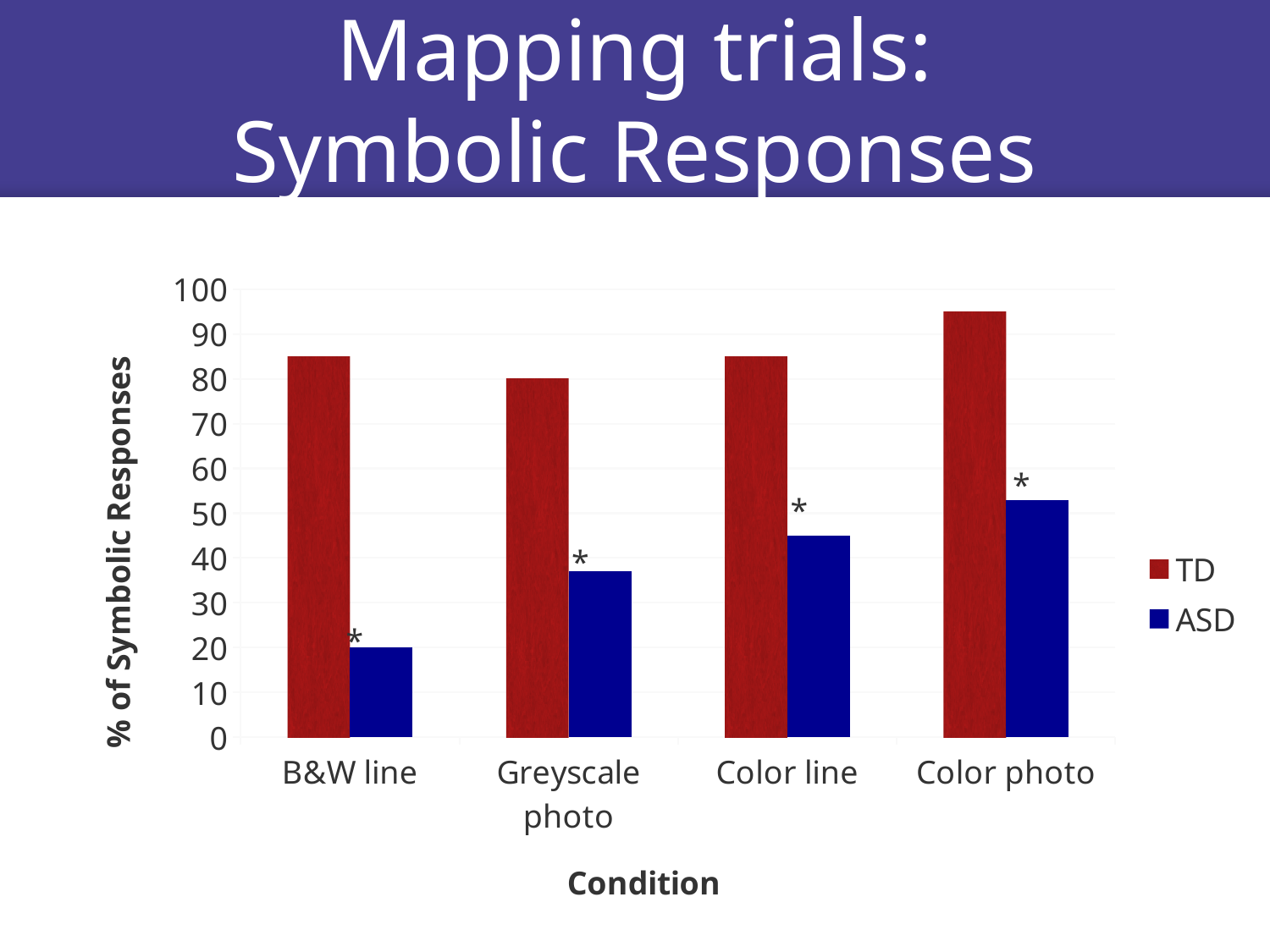
Is the ASD value for Greyscale photo greater or less than 40? less Is the ASD value for Color photo greater or less than 50? greater How many series does the legend list? 2 Which condition has the highest value for the TD series? Color photo Which condition has the highest value for the ASD series? Color photo For the Color line condition, which series has the larger value, TD or ASD? TD What kind of chart is shown on the slide? bar chart Is the TD value for Color photo greater or less than 90? greater How many conditions are shown on the x axis? 4 What is the title of the y axis? % of Symbolic Responses Do the ASD values rise or fall from B&W line to Color photo along the x axis? rise Which condition has the lowest value for the ASD series? B&W line